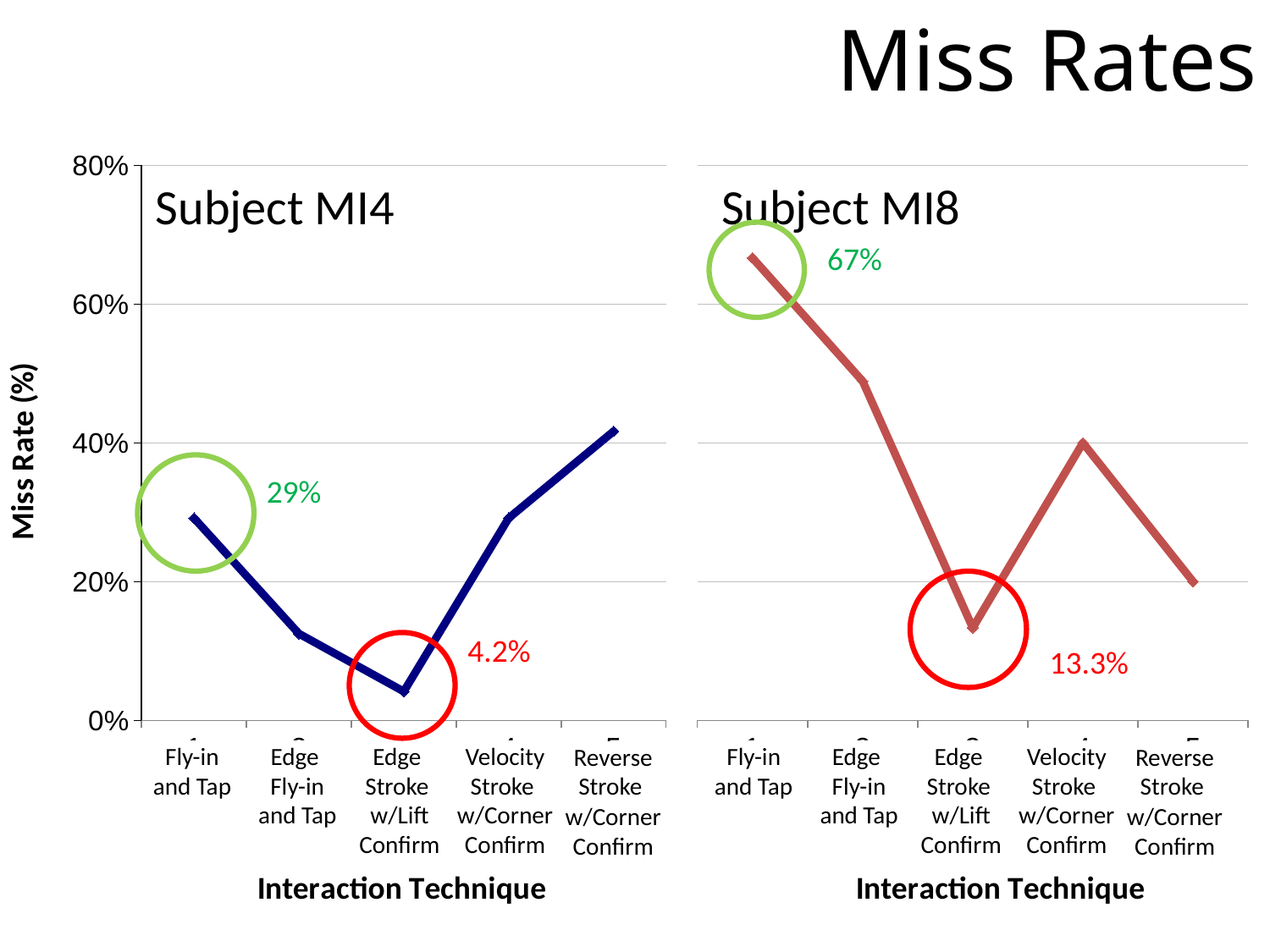
In the Subject MI4 chart, what is the miss rate for Fly-in and Tap? 29% In the Subject MI8 chart, what is the difference between the miss rates for Fly-in and Tap and Edge Stroke w/Lift Confirm? 53.3% In the Subject MI4 chart, which interaction technique has the highest miss rate? Reverse Stroke w/Corner Confirm In the Subject MI4 chart, what is the miss rate for Edge Stroke w/Lift Confirm? 4.2% In the Subject MI8 chart, what is the miss rate for Fly-in and Tap? 67% In the Subject MI8 chart, is the miss rate for Edge Fly-in and Tap greater or less than 40%? greater In the Subject MI8 chart, which interaction technique has the lowest miss rate? Edge Stroke w/Lift Confirm In the Subject MI8 chart, what is the miss rate for Edge Stroke w/Lift Confirm? 13.3% Which subject has the higher miss rate for Fly-in and Tap, MI4 or MI8? MI8 In the Subject MI4 chart, what is the difference between the miss rates for Fly-in and Tap and Edge Stroke w/Lift Confirm? 25% How many interaction techniques are plotted in the Subject MI4 chart? 5 In the Subject MI4 chart, is the miss rate for Reverse Stroke w/Corner Confirm greater or less than 40%? greater